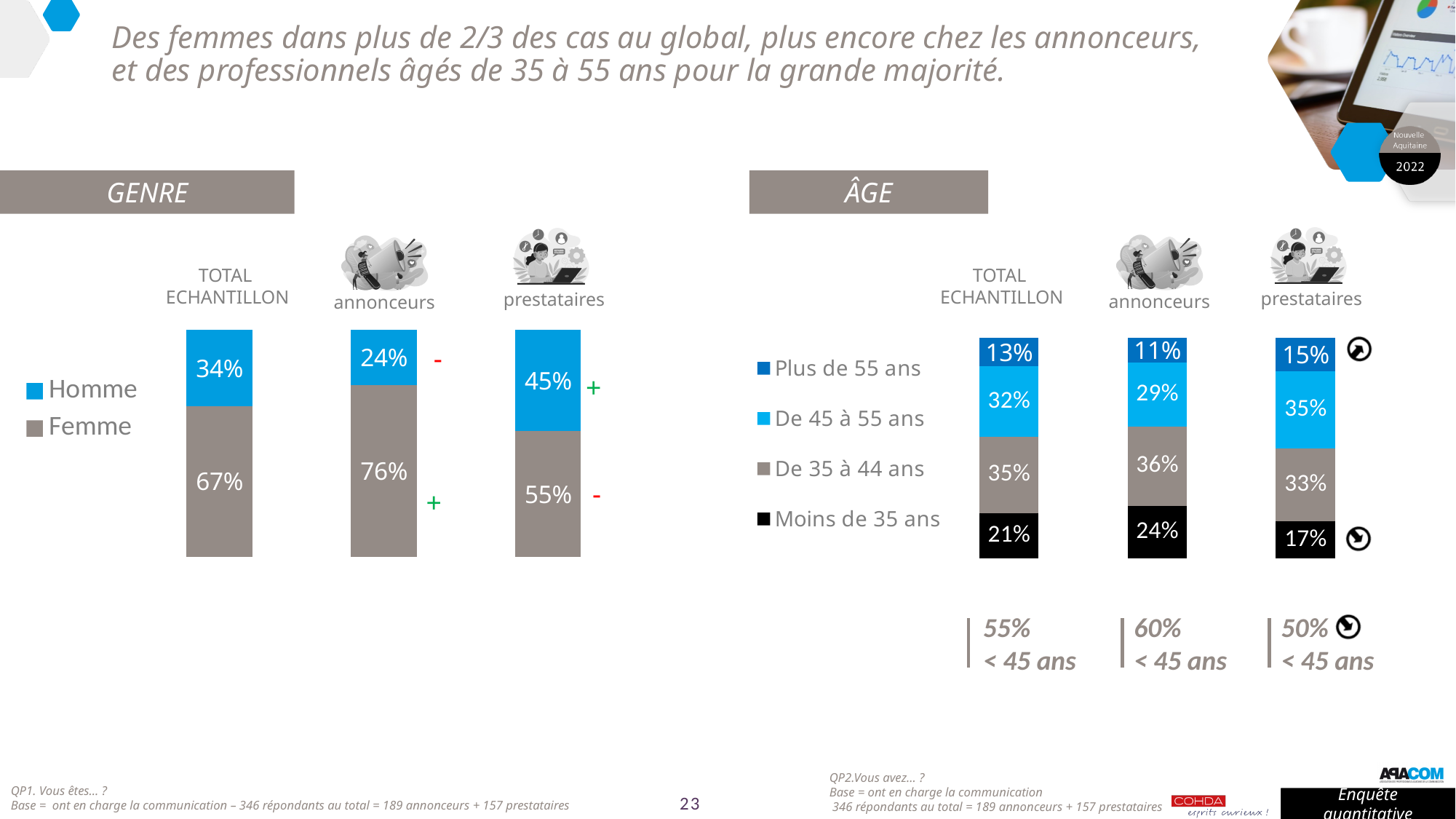
In the GENRE chart, which group has the highest Homme share? prestataires In the GENRE chart, what is the Femme share for annonceurs? 76% In the GENRE chart, what is the difference in percentage points between Femme and Homme for TOTAL ECHANTILLON? 33 percentage points How many series does the legend of the ÂGE chart list? 4 What kind of chart is the ÂGE chart? Stacked bar chart In the ÂGE chart, what is the share of Moins de 35 ans for annonceurs? 24% In the ÂGE chart, what is the share of De 45 à 55 ans for prestataires? 35% How many series does the legend of the GENRE chart list? 2 In the ÂGE chart, is the share of De 35 à 44 ans larger for TOTAL ECHANTILLON or for annonceurs? annonceurs How many bars (groups) are shown in the ÂGE chart? 3 In the ÂGE chart, which group has the lowest share of Plus de 55 ans? annonceurs In the GENRE chart, what is the Homme share for prestataires? 45%